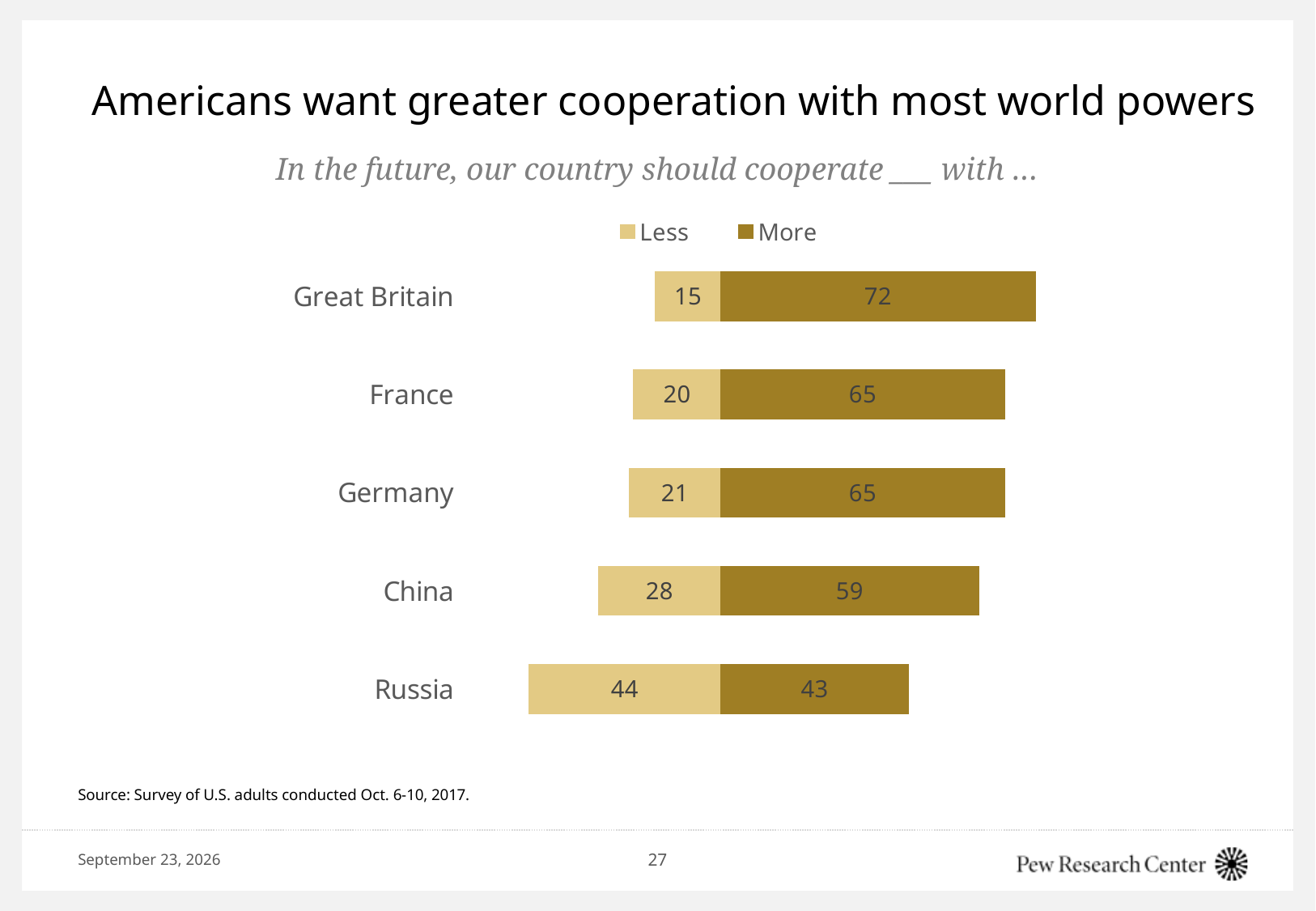
What is the 'More' value for China? 59 Which country has the lowest 'Less' value? Great Britain Which is larger: the 'Less' value for China or the 'Less' value for Germany? China What percentage of Americans say the U.S. should cooperate more with Great Britain? 72 How many series does the legend list? 2 What are the two legend entries in the chart? Less and More What is the total of the 'Less' and 'More' values for France? 85 What is the difference between the 'More' values for Great Britain and Russia? 29 Which country has the highest 'More' value? Great Britain How many countries are shown in the chart? 5 What is the 'Less' value for Russia? 44 What kind of chart is shown on the slide? Bar chart